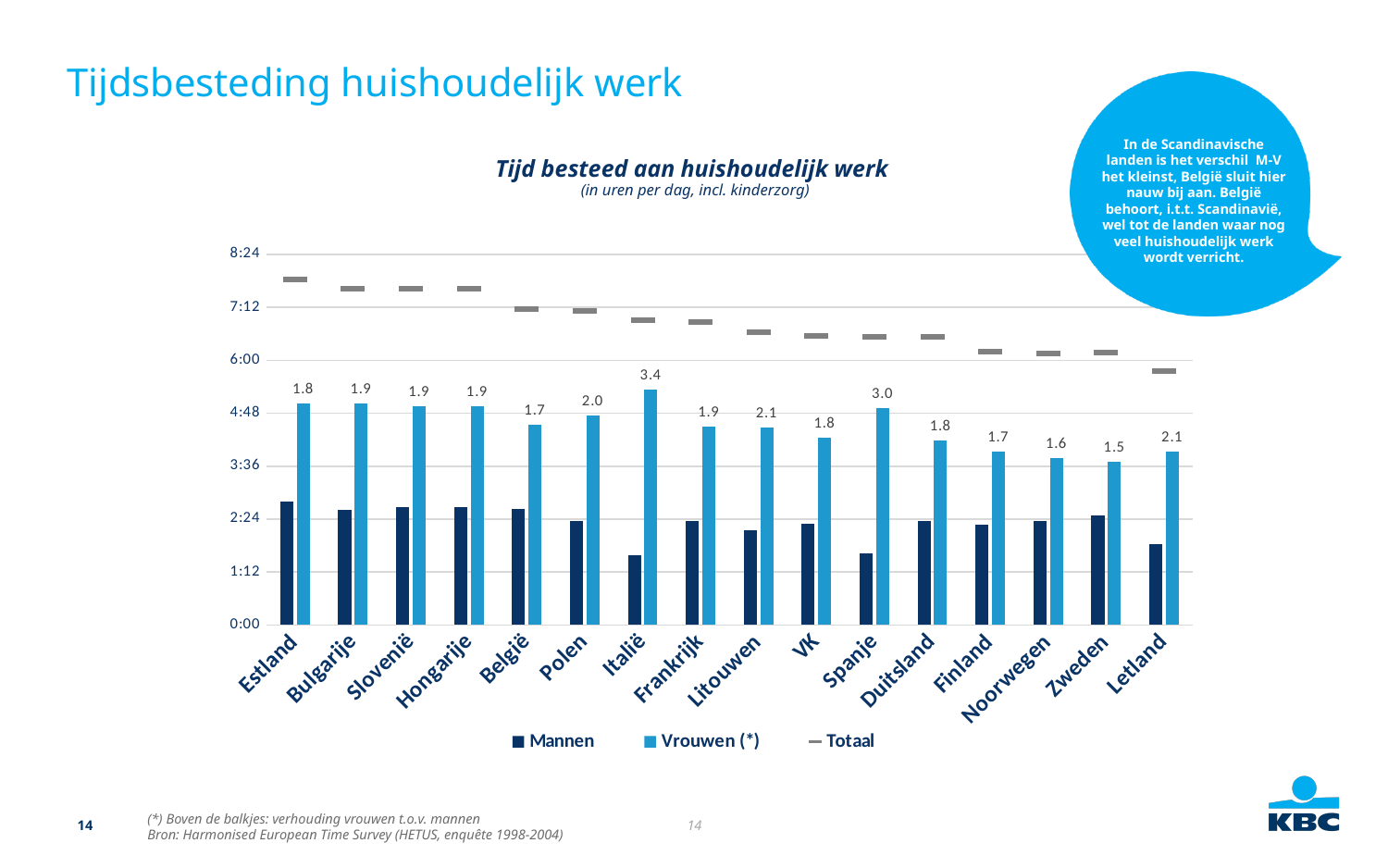
How many series does the legend list? 3 What is the data label shown above the bars for Italië? 3.4 Is the Totaal marker for Letland greater or less than 6:00? less How many countries are shown on the x axis? 16 What is the difference between the data labels for Italië and Spanje? 0.4 What is the data label shown above the bars for Spanje? 3.0 Do the Totaal markers rise or fall from left to right along the x axis? fall What is the data label shown above the bars for Zweden? 1.5 Which country has the highest data label (ratio of women to men)? Italië Is the Mannen value for Estland greater or less than 2:24? greater Which country has the lowest data label (ratio of women to men)? Zweden Which has a larger data label, Letland or Noorwegen? Letland